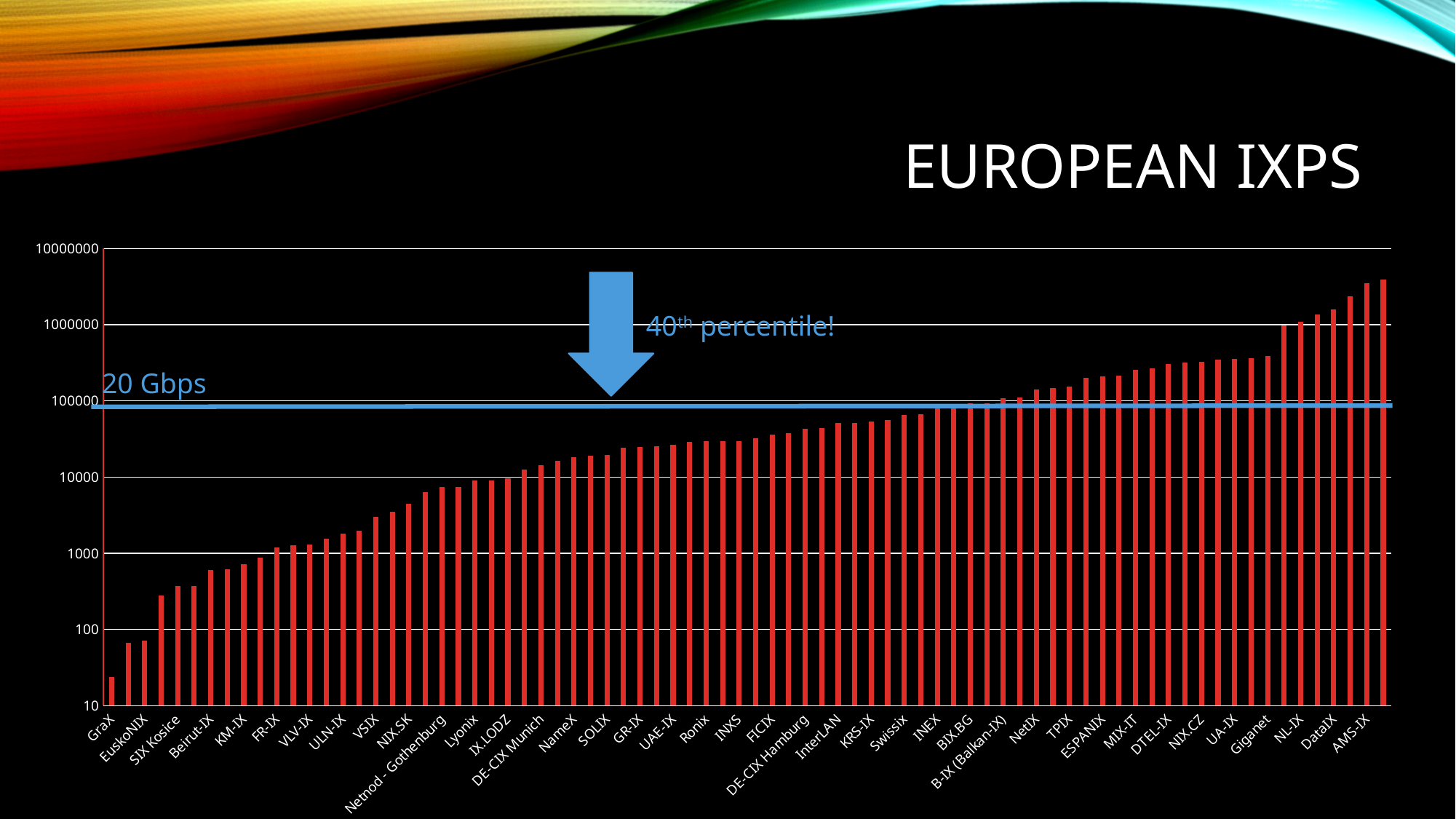
What label is given to the blue horizontal line drawn across the chart? 20 Gbps Which IXP has the lowest value in the chart? GraX Is the value for Swissix greater or less than 100000? less Is the value for AMS-IX greater or less than 1000000? greater What text annotation accompanies the blue arrow on the chart? 40th percentile! Which has the larger value, ESPANIX or VSIX? ESPANIX Do the bar values rise or fall from left to right along the x axis? rise Is the value for DE-CIX Munich greater or less than 10000? greater What kind of chart is shown on the slide? bar chart